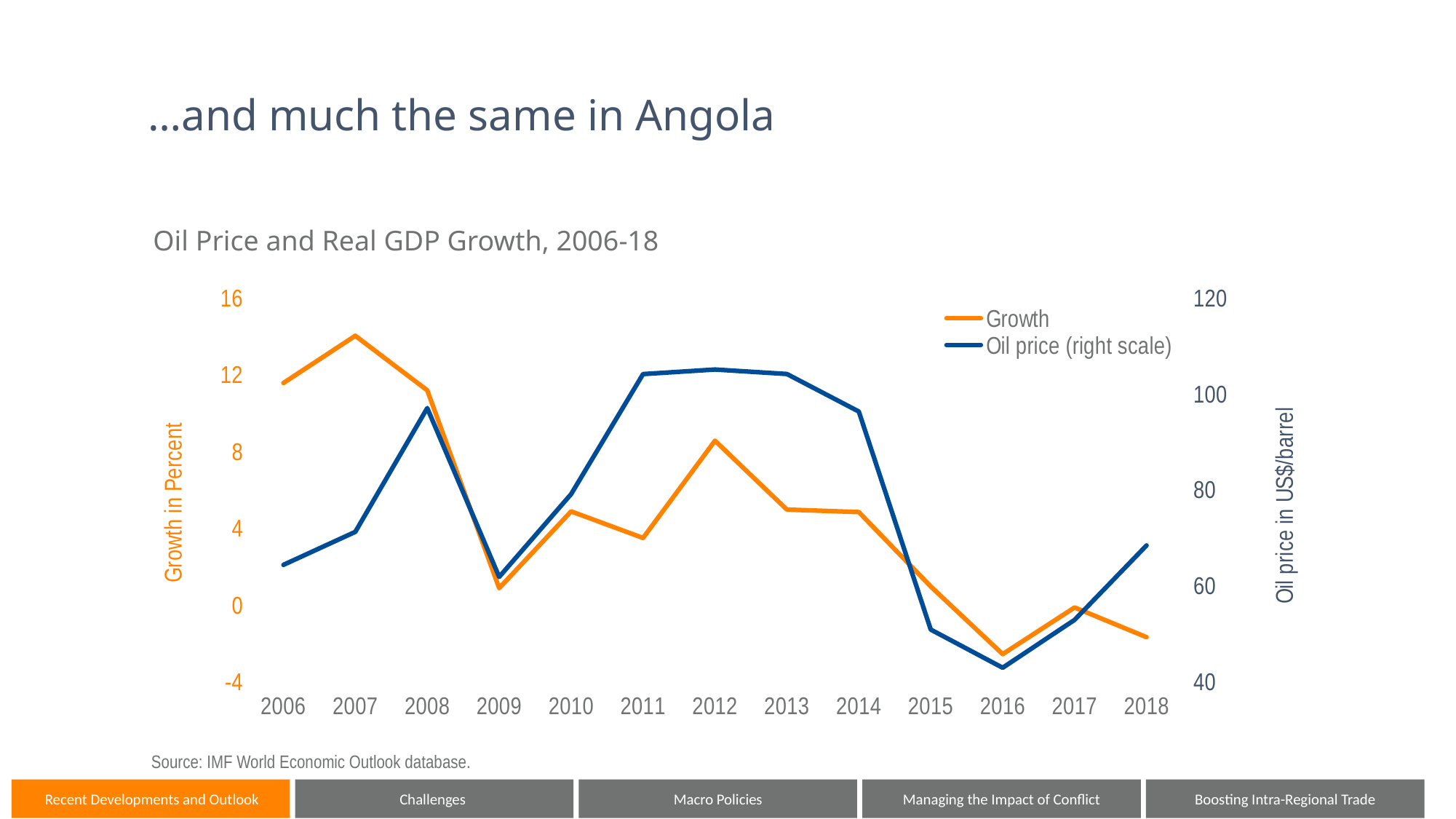
In which year is Growth highest? 2007 How many years are plotted along the x axis? 13 In which year is the Oil price lowest? 2016 What kind of chart is shown on the slide? Line chart What is the title of the chart? Oil Price and Real GDP Growth, 2006-18 Does the Oil price rise or fall from 2014 to 2016? Fall Is the Oil price value for 2016 greater or less than 60? less How many series does the legend list? 2 Which is larger, the Oil price in 2008 or in 2009? 2008 Is the Growth value for 2016 greater or less than 0? less Is the Growth value for 2007 greater or less than 12? greater In which year is Growth lowest? 2016